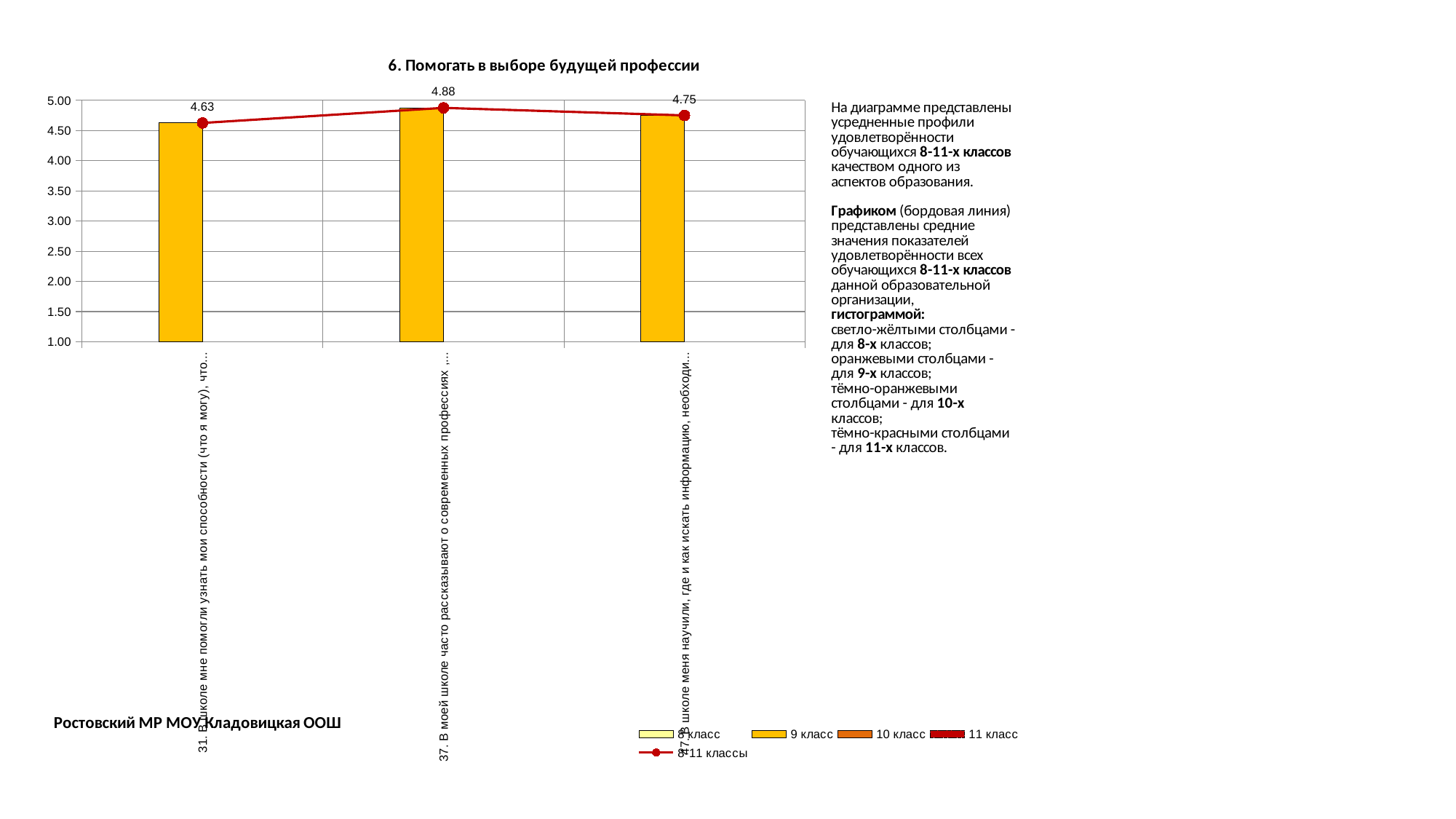
What is the title of the chart? 6. Помогать в выборе будущей профессии What is the difference between the 8-11 классы values for item 37 and item 31? 0.25 What is the value of the 8-11 классы line for item 31? 4.63 Which item has the highest value on the 8-11 классы line? 37 Which has the larger 8-11 классы value, item 37 or item 47? 37 How many items (categories) are shown on the x axis? 3 What is the value of the 8-11 классы line for item 37? 4.88 Is the 9 класс bar for item 31 greater or less than 4.50? greater What is the value of the 8-11 классы line for item 47? 4.75 Which item has the lowest value on the 8-11 классы line? 31 How many series does the legend list? 5 What kind of chart is shown on the slide? bar chart with a line